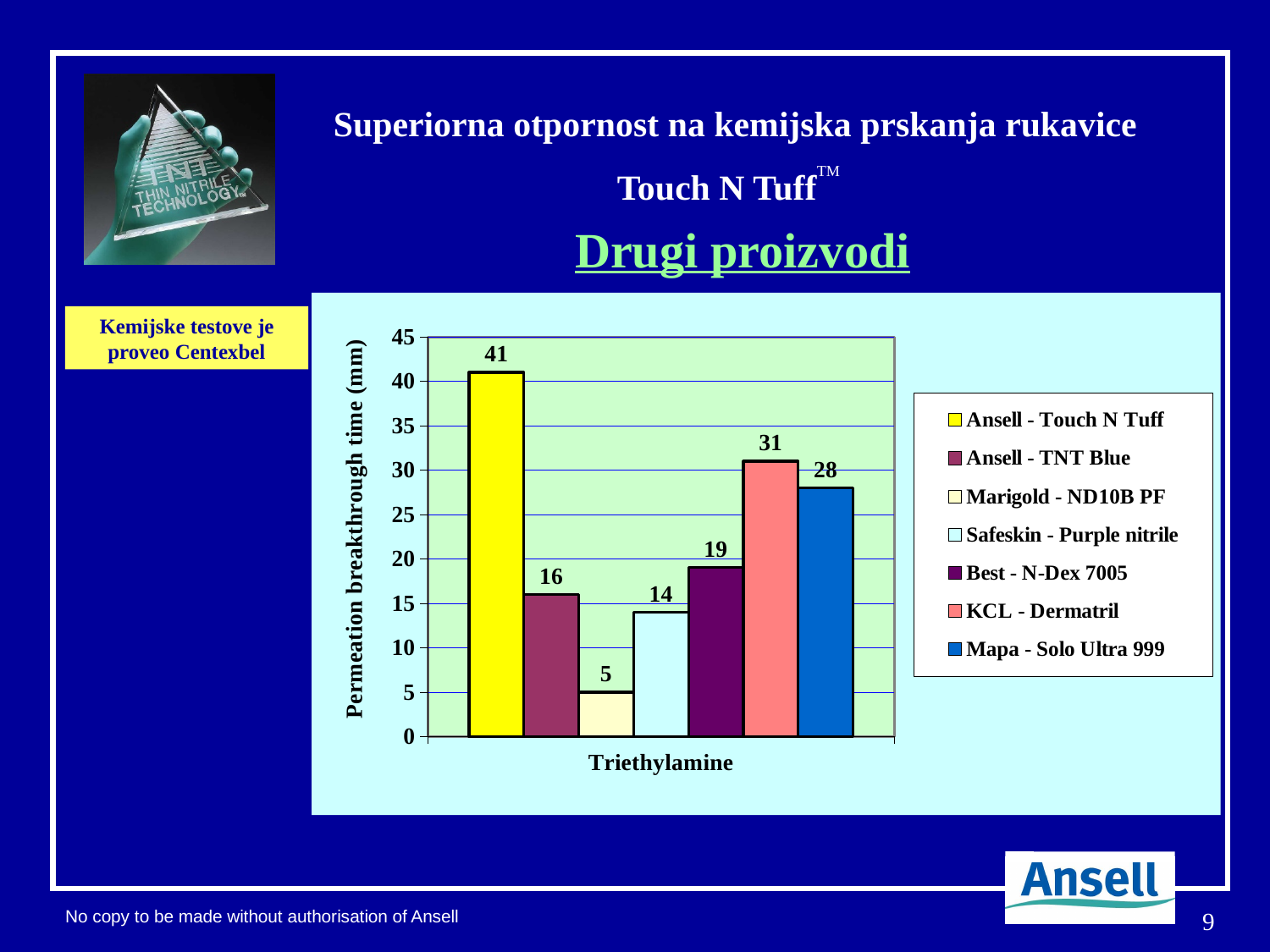
What kind of chart is shown on the slide? Bar chart Which product has the lowest permeation breakthrough time? Marigold - ND10B PF How many series does the legend list? 7 What is the difference between the values for Ansell - Touch N Tuff and KCL - Dermatril? 10 What is the y-axis title of the chart? Permeation breakthrough time (mm) Which product has the highest permeation breakthrough time? Ansell - Touch N Tuff What is the label on the x axis of the chart? Triethylamine What is the permeation breakthrough time for Marigold - ND10B PF? 5 Which is larger, the value for Ansell - TNT Blue or Best - N-Dex 7005? Best - N-Dex 7005 What is the value for KCL - Dermatril? 31 What is the permeation breakthrough time for Ansell - Touch N Tuff? 41 What is the value for Mapa - Solo Ultra 999? 28